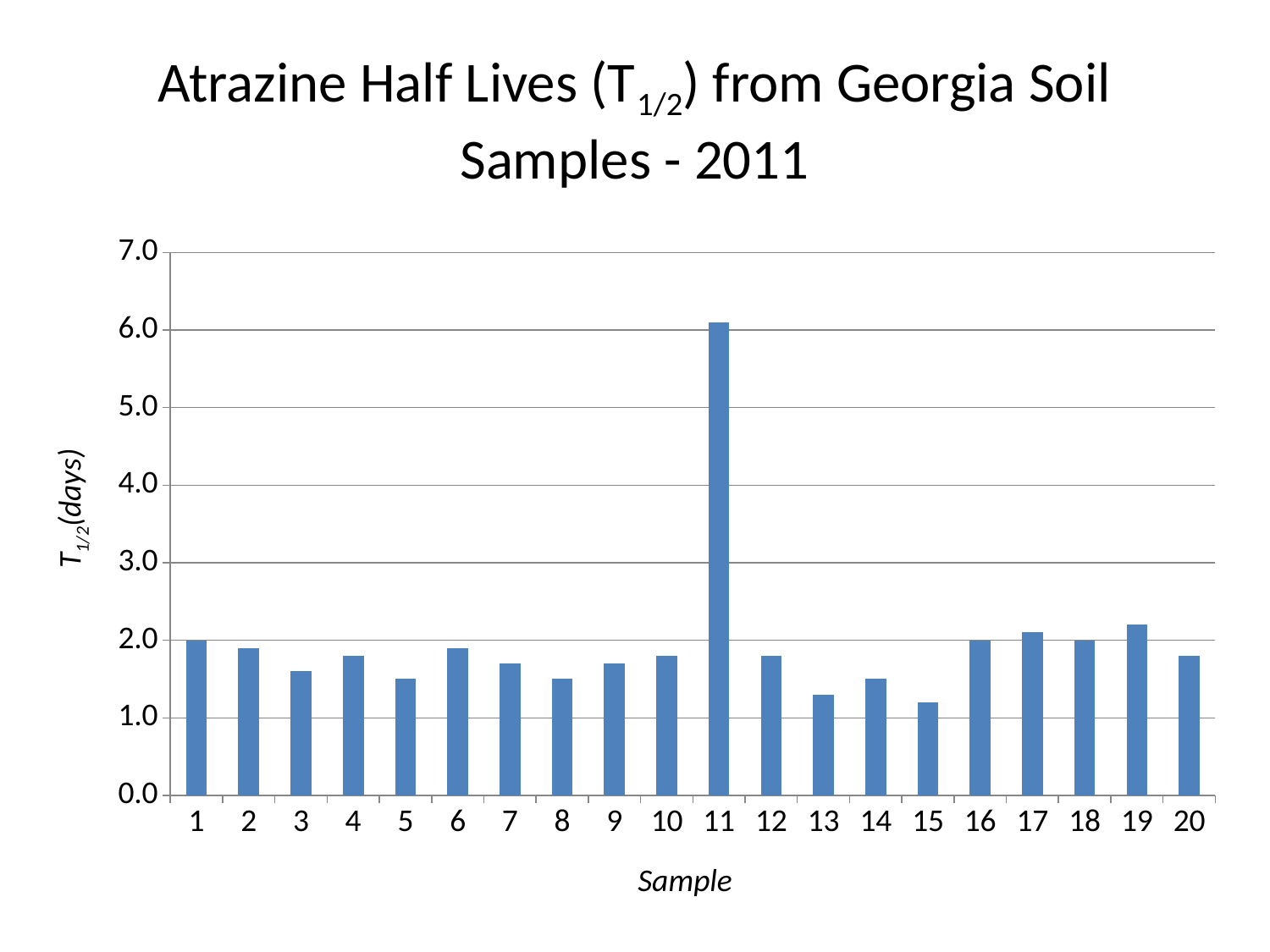
Which sample has the highest half life? 11 What is the label on the x axis? Sample What kind of chart is shown on the slide? bar chart Is the value for sample 19 greater or less than 2.0? greater How many samples are plotted on the x axis? 20 Which has a larger value, sample 19 or sample 5? sample 19 Is the value for sample 3 greater or less than 2.0? less What is the half life value for sample 1? 2.0 Is the value for sample 15 greater or less than 1.5? less What is the title of the chart? Atrazine Half Lives (T1/2) from Georgia Soil Samples - 2011 What is the half life value for sample 16? 2.0